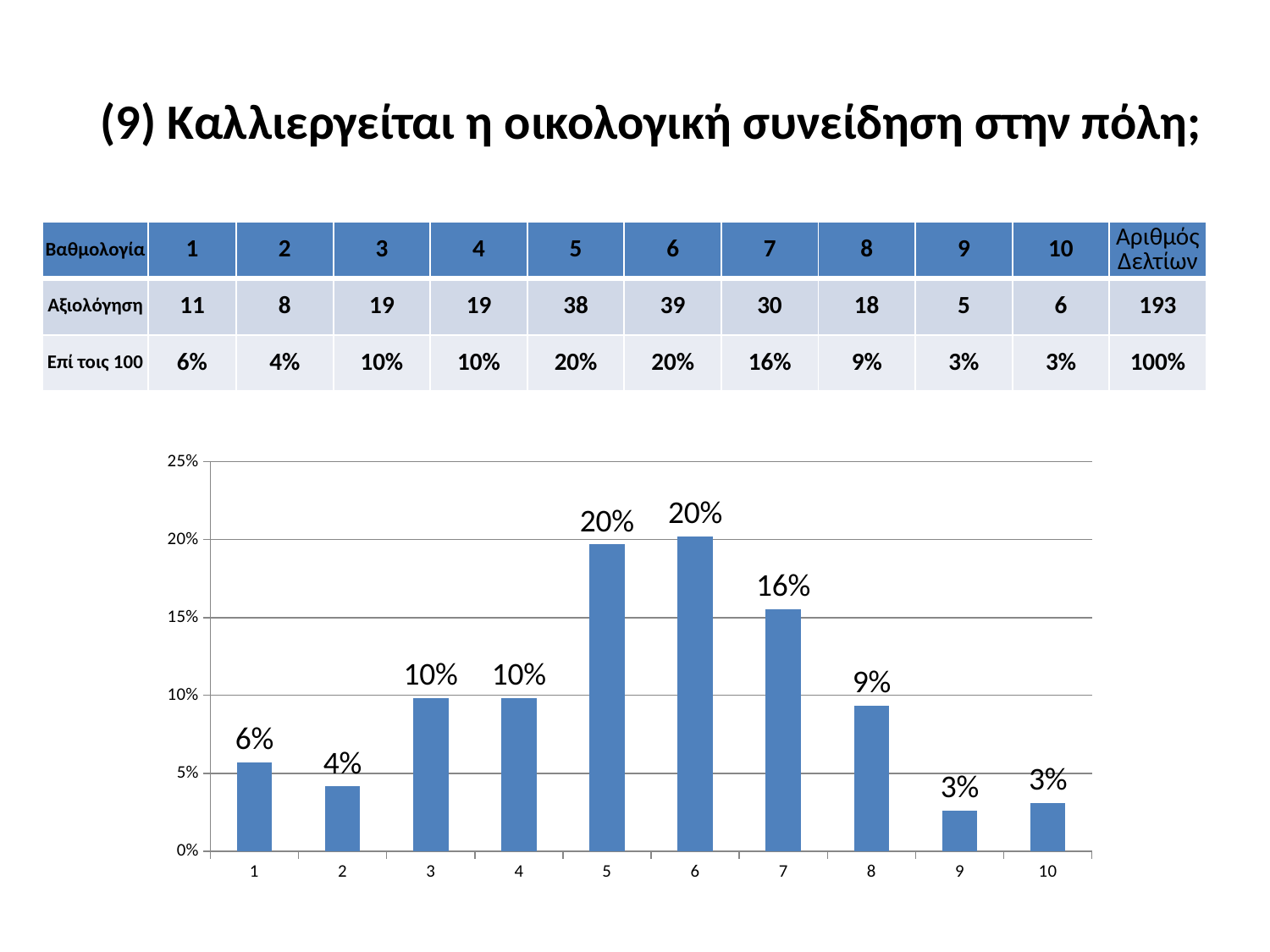
How many categories are shown on the x axis of the bar chart? 10 Which has the larger value in the bar chart, category 3 or category 2? 3 What is the difference between the values for category 6 and category 2 in the bar chart? 16% What is the value shown for category 1 in the bar chart? 6% Which has the larger value in the bar chart, category 8 or category 7? 7 What is the value shown for category 7 in the bar chart? 16% What kind of chart is shown on the slide? bar chart What is the difference between the values for category 7 and category 8 in the bar chart? 7% Is the value for category 7 in the bar chart greater or less than 15%? greater What is the value shown for category 5 in the bar chart? 20% What is the value shown for category 8 in the bar chart? 9% Do the values in the bar chart rise or fall from category 6 to category 10? fall